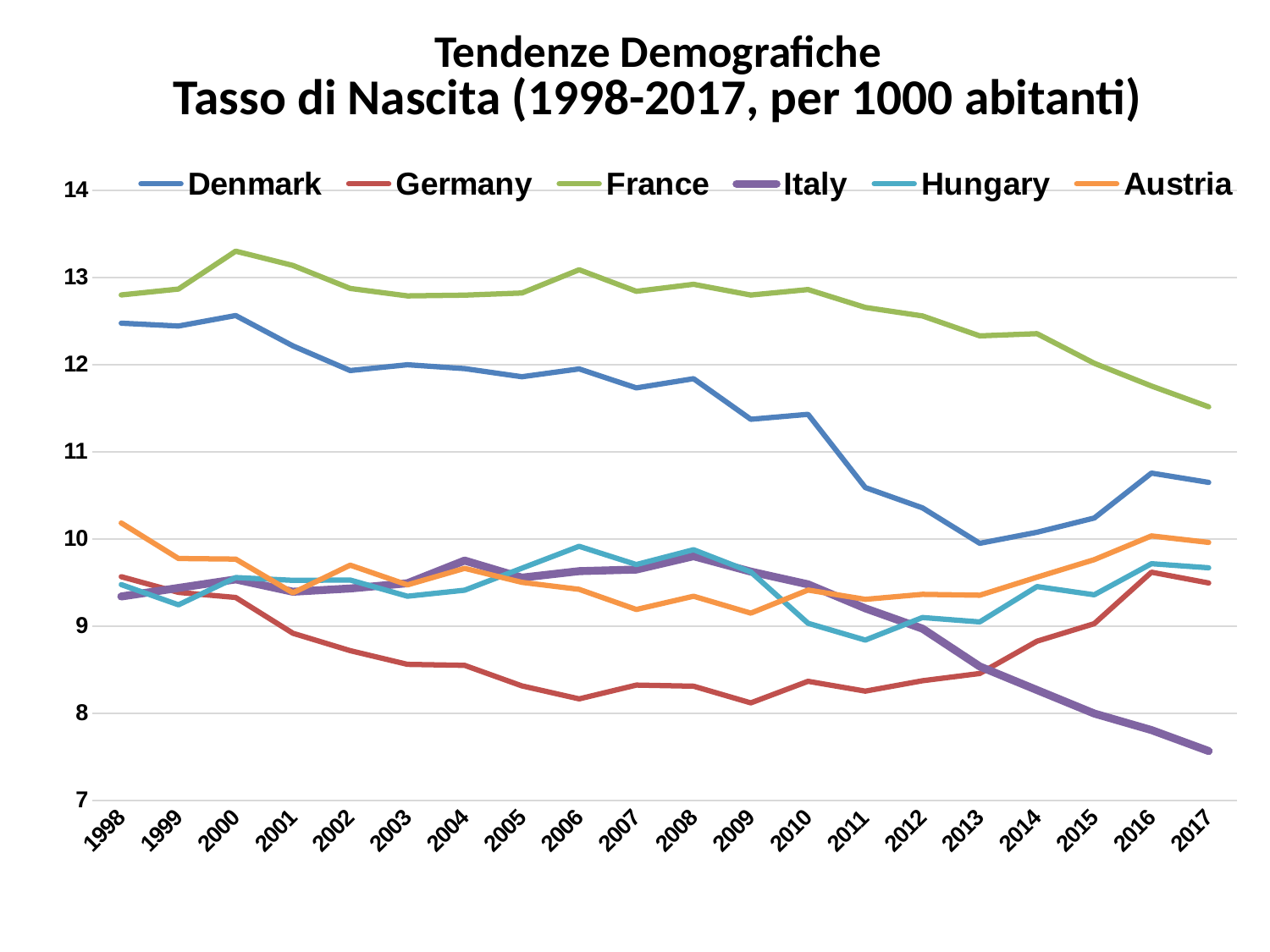
How many years are shown on the x axis? 20 How many series does the legend list? 6 Is the value for Denmark in 2011 greater or less than 11? less Does the line for Italy rise or fall from 2008 to 2017? fall Which country has the lowest birth rate in 2017? Italy What is the title of the chart? Tendenze Demografiche Tasso di Nascita (1998-2017, per 1000 abitanti) Is the value for France in 2000 greater or less than 13? greater Which country has the highest birth rate in 1998? France Which is larger in 2017, the value for Germany or the value for Italy? Germany What type of chart is shown on the slide? line chart Is the value for Italy in 2017 greater or less than 8? less Which country has the highest birth rate in 2017? France